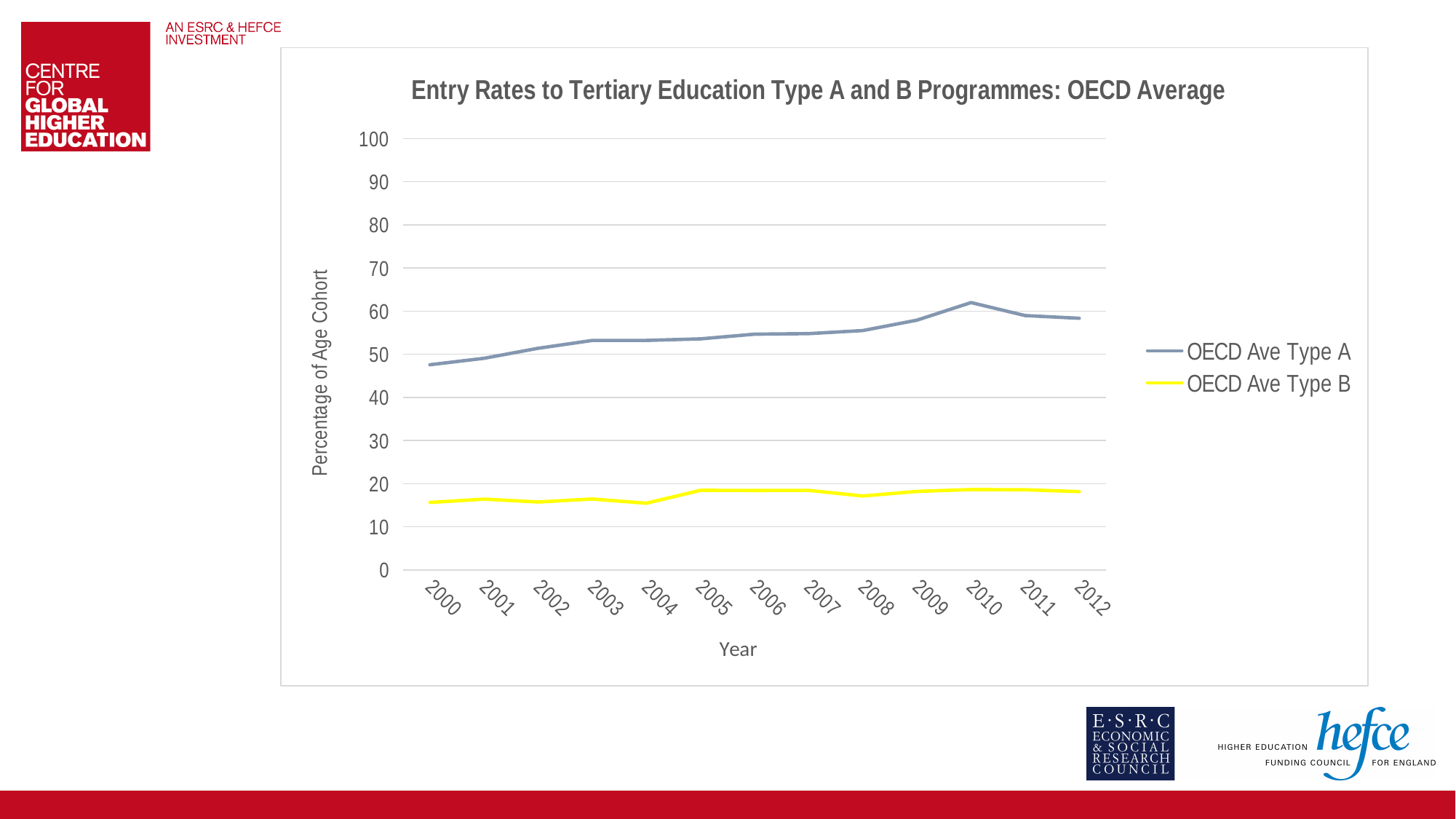
In which year does the OECD Ave Type A series reach its highest value? 2010 What is the title of the chart? Entry Rates to Tertiary Education Type A and B Programmes: OECD Average What is the label on the y axis? Percentage of Age Cohort What kind of chart is shown on the slide? line chart How many series does the legend list? 2 Does the OECD Ave Type A series generally rise or fall between 2000 and 2010? rise In which year is the OECD Ave Type A series at its lowest value? 2000 How many years are plotted along the x axis? 13 Which series has the higher value in 2012, OECD Ave Type A or OECD Ave Type B? OECD Ave Type A Is the value for OECD Ave Type B in 2004 greater or less than 20? less Is the value for OECD Ave Type A in 2000 greater or less than 50? less Is the value for OECD Ave Type A in 2010 greater or less than 60? greater